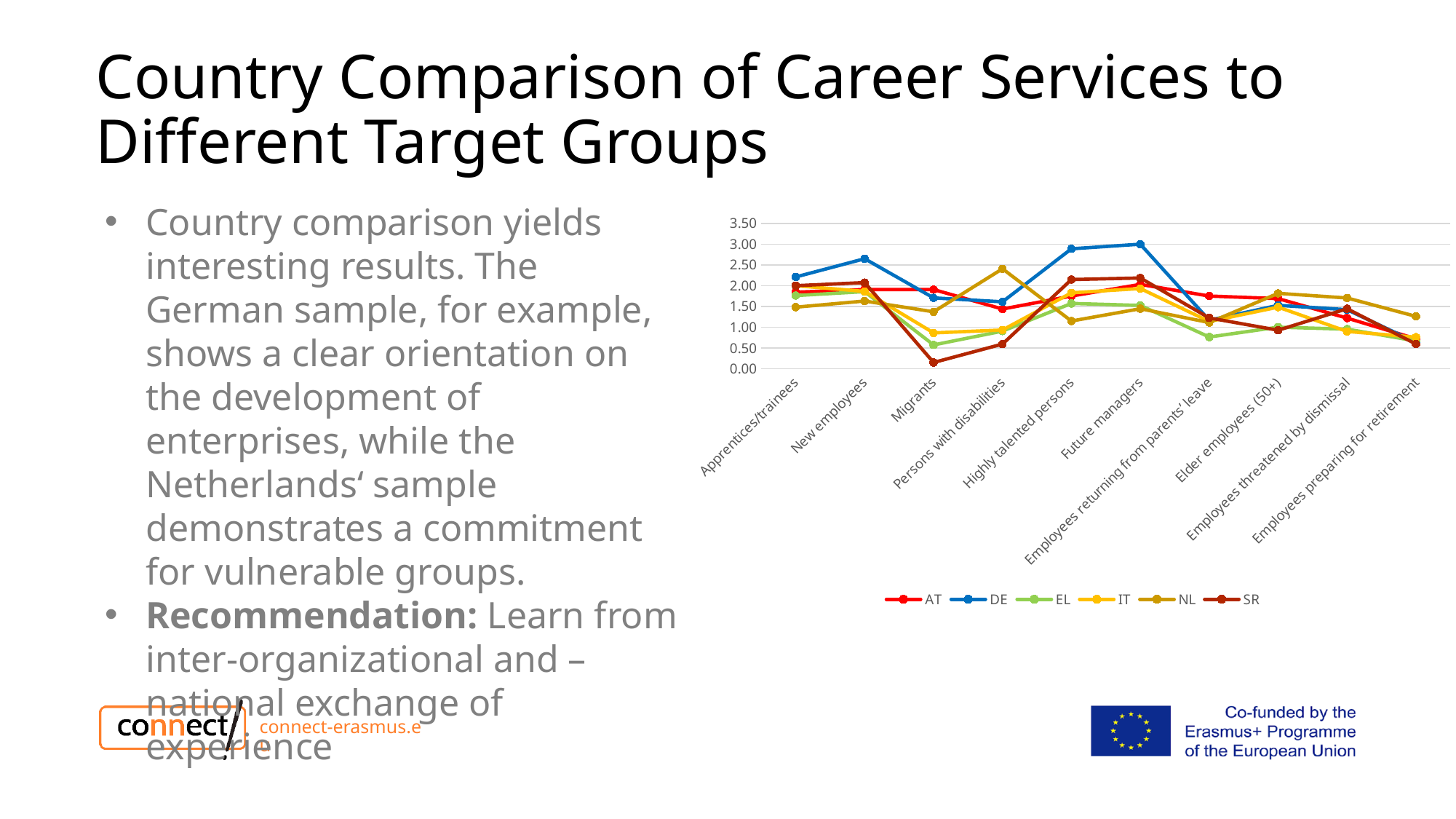
Is the EL value for Employees returning from parents' leave greater or less than 1.00? less How many target-group categories are shown on the x axis of the chart? 10 Is the SR value for Migrants greater or less than 0.50? less Which series has the highest value for Future managers? DE How many series does the chart legend list? 6 Which series has the lowest value for Migrants? SR What kind of chart is shown on the slide? line chart Which series in the legend is drawn in blue? DE For Migrants, which is larger: the DE value or the SR value? DE Which series has the highest value for Persons with disabilities? NL Is the DE value for Future managers greater or less than 2.50? greater Does the DE line rise or fall from Future managers to Employees returning from parents' leave? fall